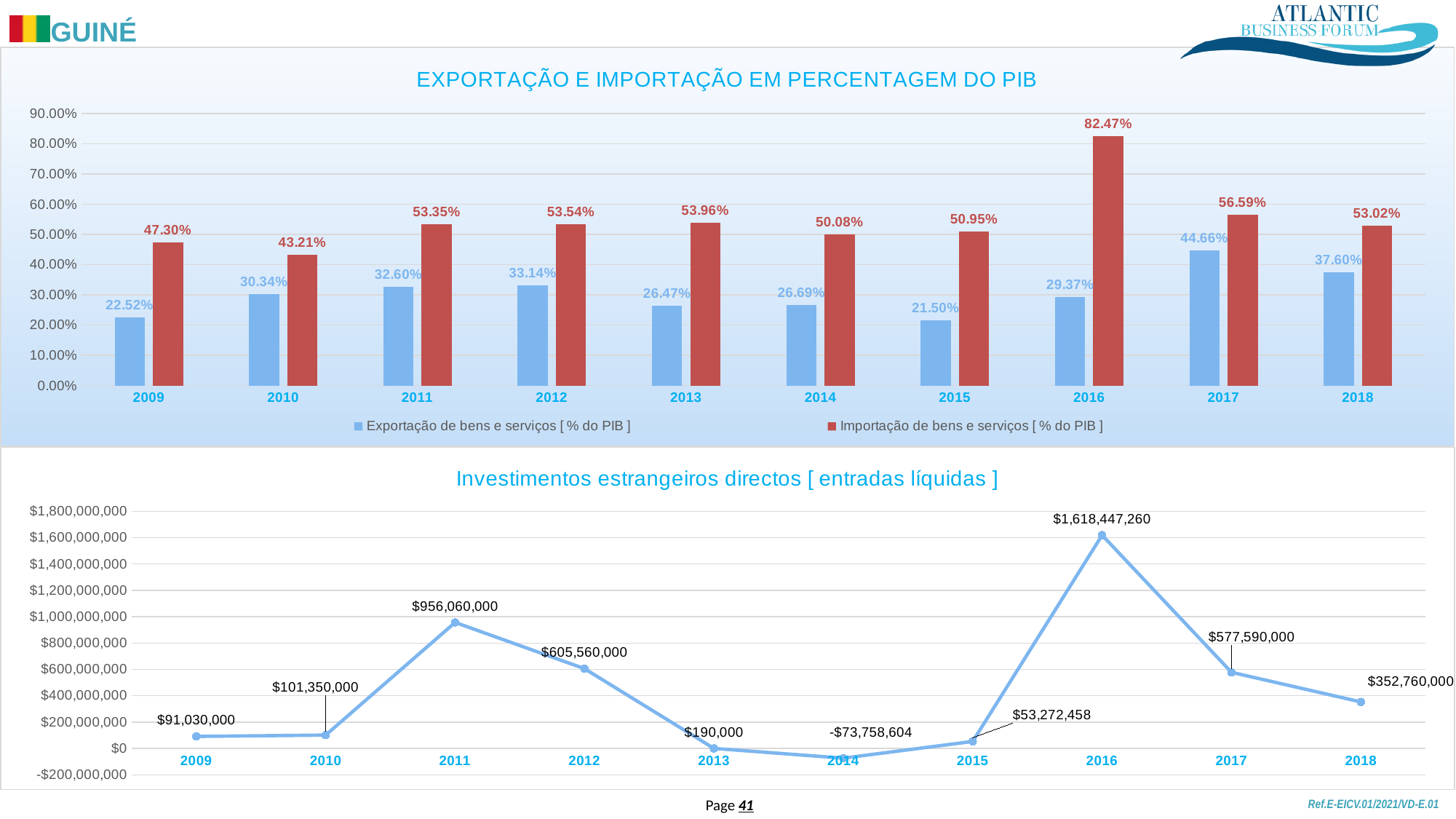
In the chart 'EXPORTAÇÃO E IMPORTAÇÃO EM PERCENTAGEM DO PIB', how many series does the legend list? 2 In the chart 'Investimentos estrangeiros directos [ entradas líquidas ]', how many years are plotted? 10 In the chart 'EXPORTAÇÃO E IMPORTAÇÃO EM PERCENTAGEM DO PIB', what is the difference between Importação and Exportação in 2018? 15.42% In the chart 'Investimentos estrangeiros directos [ entradas líquidas ]', what is the difference between the 2011 and 2012 values? $350,500,000 In the chart 'EXPORTAÇÃO E IMPORTAÇÃO EM PERCENTAGEM DO PIB', which year has the lowest Exportação de bens e serviços value? 2015 In the chart 'EXPORTAÇÃO E IMPORTAÇÃO EM PERCENTAGEM DO PIB', what is the value of Importação de bens e serviços for 2016? 82.47% In the chart 'Investimentos estrangeiros directos [ entradas líquidas ]', which year has the lowest value? 2014 What kind of chart is the bottom chart on the slide? Line chart In the chart 'Investimentos estrangeiros directos [ entradas líquidas ]', what is the value for 2016? $1,618,447,260 In the chart 'EXPORTAÇÃO E IMPORTAÇÃO EM PERCENTAGEM DO PIB', which is larger in 2010: Exportação or Importação? Importação What kind of chart is the top chart on the slide? Bar chart In the chart 'EXPORTAÇÃO E IMPORTAÇÃO EM PERCENTAGEM DO PIB', what is the value of Exportação de bens e serviços for 2017? 44.66%